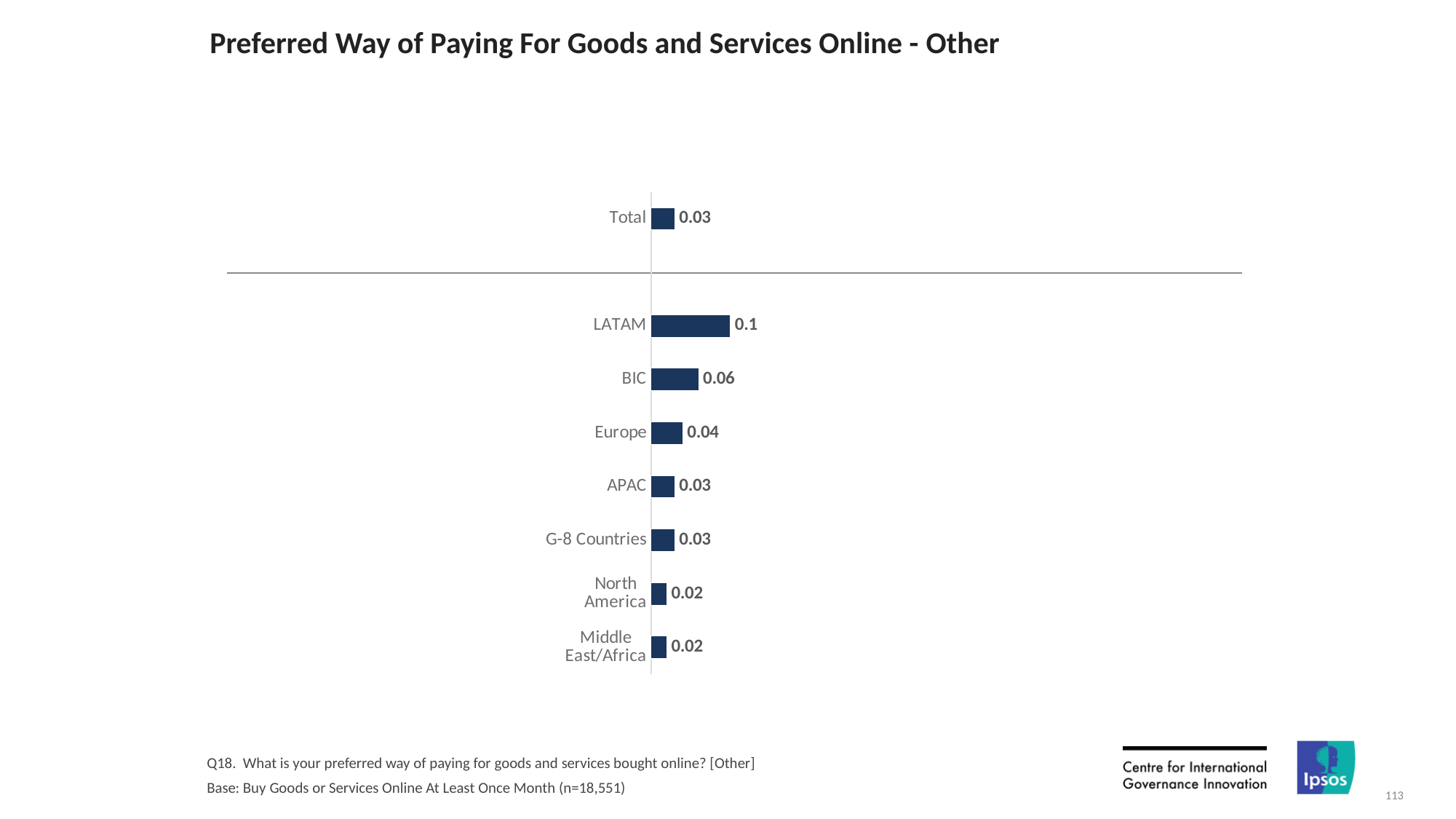
What kind of chart is shown on the slide? Bar chart What is the value for North America? 0.02 What is the value for BIC? 0.06 Which region has the highest value? LATAM What is the value for LATAM? 0.1 What is the value for Europe? 0.04 What is the value for Total? 0.03 Which is larger, the value for BIC or the value for Europe? BIC How many bars are plotted on the chart, including Total? 8 What is the difference between the values for Europe and Middle East/Africa? 0.02 What is the title of the chart? Preferred Way of Paying For Goods and Services Online - Other What is the difference between the values for LATAM and BIC? 0.04